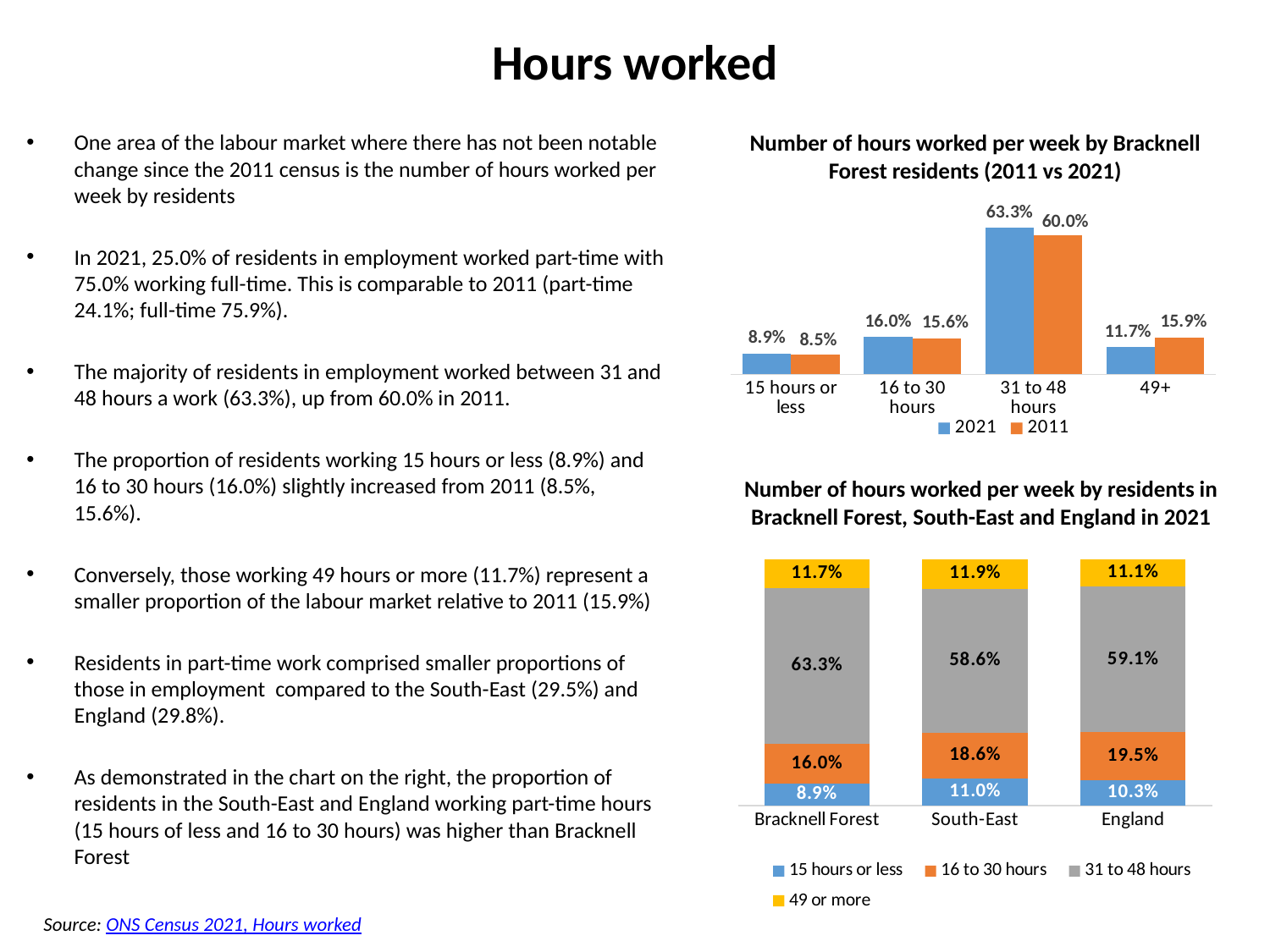
In the chart titled 'Number of hours worked per week by residents in Bracknell Forest, South-East and England in 2021', how many series does the legend list? 4 In the chart titled 'Number of hours worked per week by Bracknell Forest residents (2011 vs 2021)', how many series does the legend list? 2 In the chart titled 'Number of hours worked per week by residents in Bracknell Forest, South-East and England in 2021', what is the difference between the 15 hours or less values for South-East and England? 0.7% What kind of chart is the chart titled 'Number of hours worked per week by Bracknell Forest residents (2011 vs 2021)'? Bar chart In the chart titled 'Number of hours worked per week by Bracknell Forest residents (2011 vs 2021)', which is larger for 16 to 30 hours: the 2021 value or the 2011 value? 2021 In the chart titled 'Number of hours worked per week by residents in Bracknell Forest, South-East and England in 2021', what is the value for 16 to 30 hours in South-East? 18.6% In the chart titled 'Number of hours worked per week by Bracknell Forest residents (2011 vs 2021)', what is the difference between the 2021 and 2011 values for 49+? 4.2% In the chart titled 'Number of hours worked per week by Bracknell Forest residents (2011 vs 2021)', what is the 2021 value for 31 to 48 hours? 63.3% In the chart titled 'Number of hours worked per week by Bracknell Forest residents (2011 vs 2021)', what is the 2011 value for 49+? 15.9% In the chart titled 'Number of hours worked per week by residents in Bracknell Forest, South-East and England in 2021', which region has the highest value for 31 to 48 hours? Bracknell Forest In the chart titled 'Number of hours worked per week by residents in Bracknell Forest, South-East and England in 2021', how many regions are shown on the x axis? 3 In the chart titled 'Number of hours worked per week by Bracknell Forest residents (2011 vs 2021)', which category has the lowest 2021 value? 15 hours or less